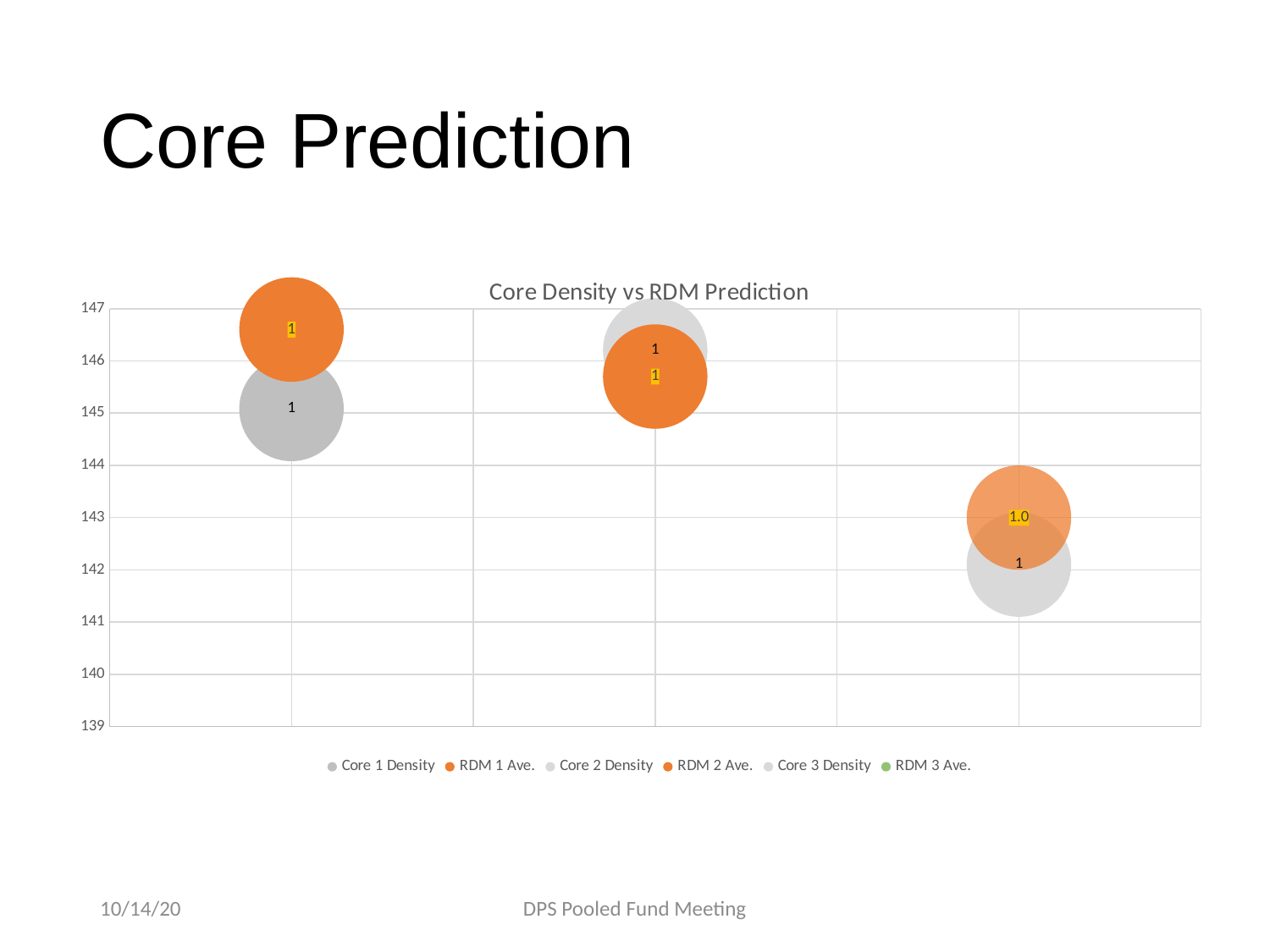
What kind of chart is shown on the slide? bubble chart What is the title of the chart? Core Density vs RDM Prediction How many series does the chart legend list? 6 Which is higher on the chart, RDM 1 Ave. or Core 1 Density? RDM 1 Ave. Which series has the lowest position on the chart? Core 3 Density Is the value for RDM 1 Ave. greater or less than 146? greater Is the value for Core 1 Density greater or less than 146? less Is the value for Core 3 Density greater or less than 143? less Which is higher on the chart, Core 1 Density or Core 3 Density? Core 1 Density